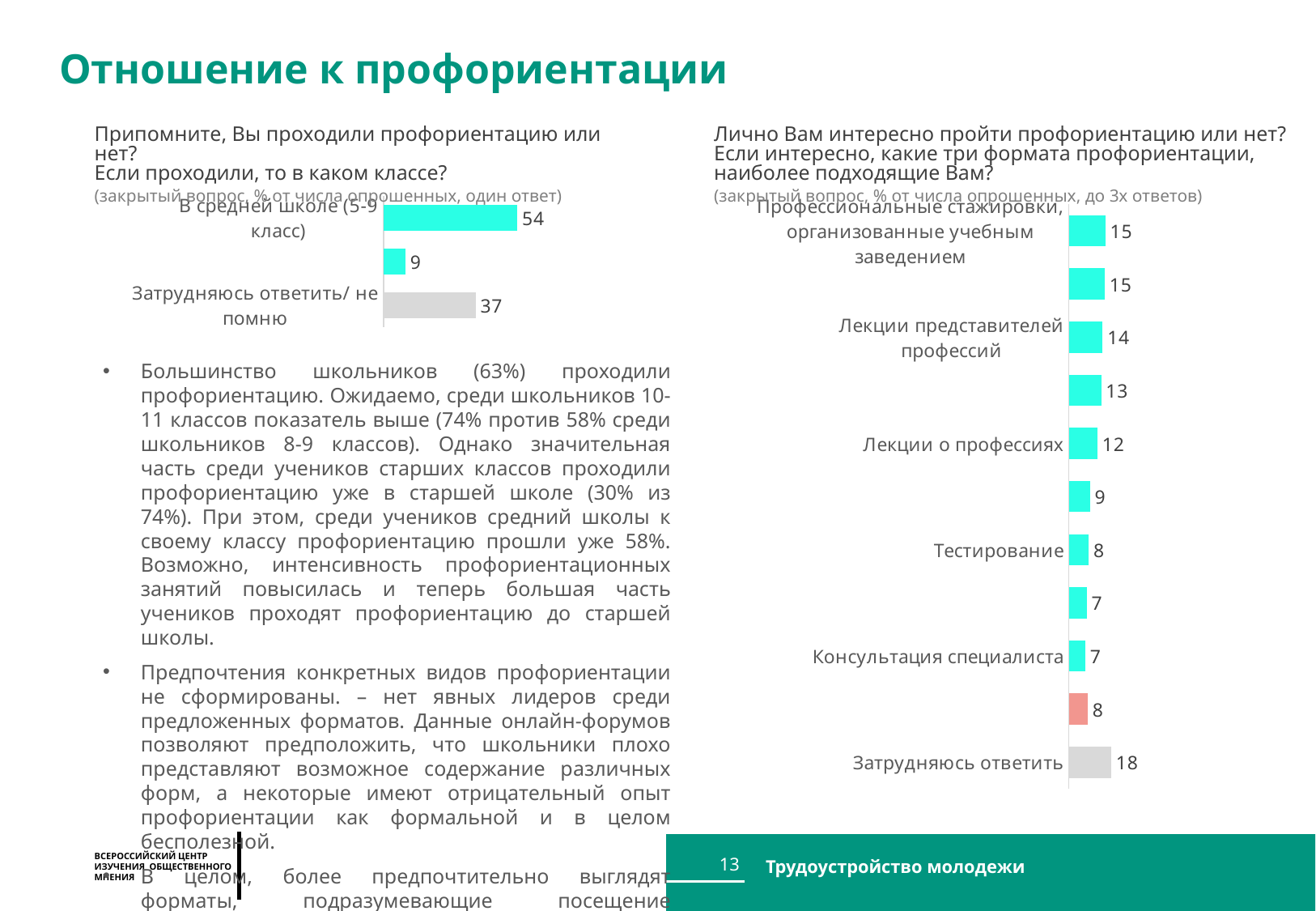
In the left chart (Припомните, Вы проходили профориентацию или нет?), what is the value for «Затрудняюсь ответить/ не помню»? 37 In the right chart (Лично Вам интересно пройти профориентацию или нет?), what is the difference between «Профессиональные стажировки, организованные учебным заведением» and «Лекции о профессиях»? 3 In the left chart (Припомните, Вы проходили профориентацию или нет?), how many bars are plotted? 3 In the right chart (Лично Вам интересно пройти профориентацию или нет?), what is the value for «Консультация специалиста»? 7 In the right chart (Лично Вам интересно пройти профориентацию или нет?), what is the value for «Тестирование»? 8 In the right chart (Лично Вам интересно пройти профориентацию или нет?), which is larger: «Лекции о профессиях» or «Тестирование»? Лекции о профессиях What type of chart is used on the right side of the slide (Лично Вам интересно пройти профориентацию или нет?)? Bar chart In the right chart (Лично Вам интересно пройти профориентацию или нет?), what is the value for «Затрудняюсь ответить»? 18 In the left chart (Припомните, Вы проходили профориентацию или нет?), what is the value for «В средней школе (5-9 класс)»? 54 In the right chart (Лично Вам интересно пройти профориентацию или нет?), what is the value for «Лекции представителей профессий»? 14 In the right chart (Лично Вам интересно пройти профориентацию или нет?), which category has the highest value? Затрудняюсь ответить In the left chart (Припомните, Вы проходили профориентацию или нет?), what is the difference between «В средней школе (5-9 класс)» and «Затрудняюсь ответить/ не помню»? 17